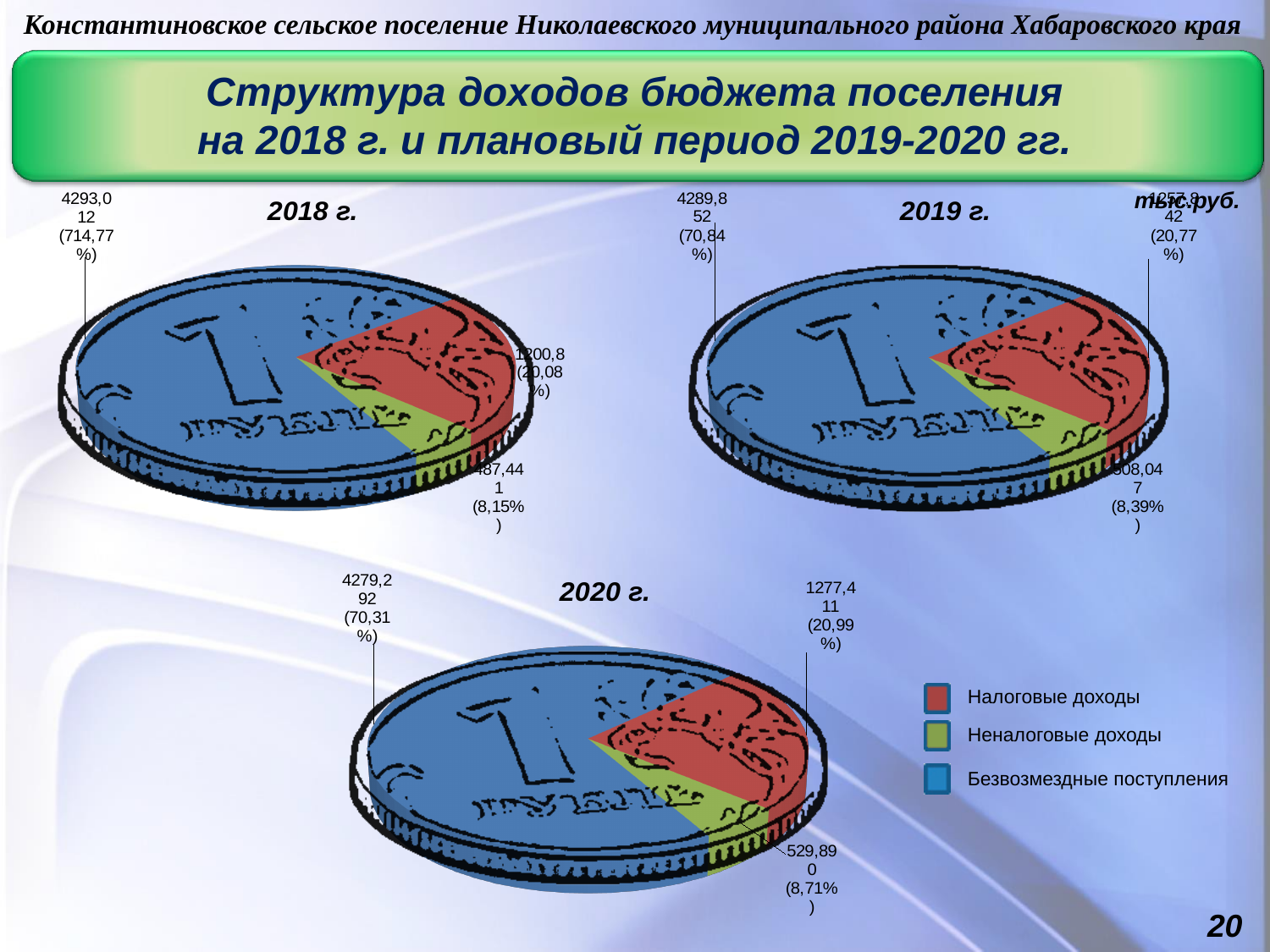
In the 2020 г. chart, which category has the largest slice? Безвозмездные поступления In the 2019 г. chart, which category has the smallest slice? Неналоговые доходы In the 2020 г. chart, what is the value for Налоговые доходы? 1277,411 In the 2020 г. chart, what share of the pie is Неналоговые доходы? 8,71% How many pie charts are shown on the slide? 3 What kind of chart is used for the 2018 г. chart? pie chart In the 2019 г. chart, what is the value for Неналоговые доходы? 508,047 In the 2020 г. chart, what is the value for Безвозмездные поступления? 4279,292 In the 2018 г. chart, what share of the pie is Неналоговые доходы? 8,15% Which colour represents Налоговые доходы in the legend? red In the 2019 г. chart, what share of the pie is Безвозмездные поступления? 70,84% How many categories does the legend list? 3